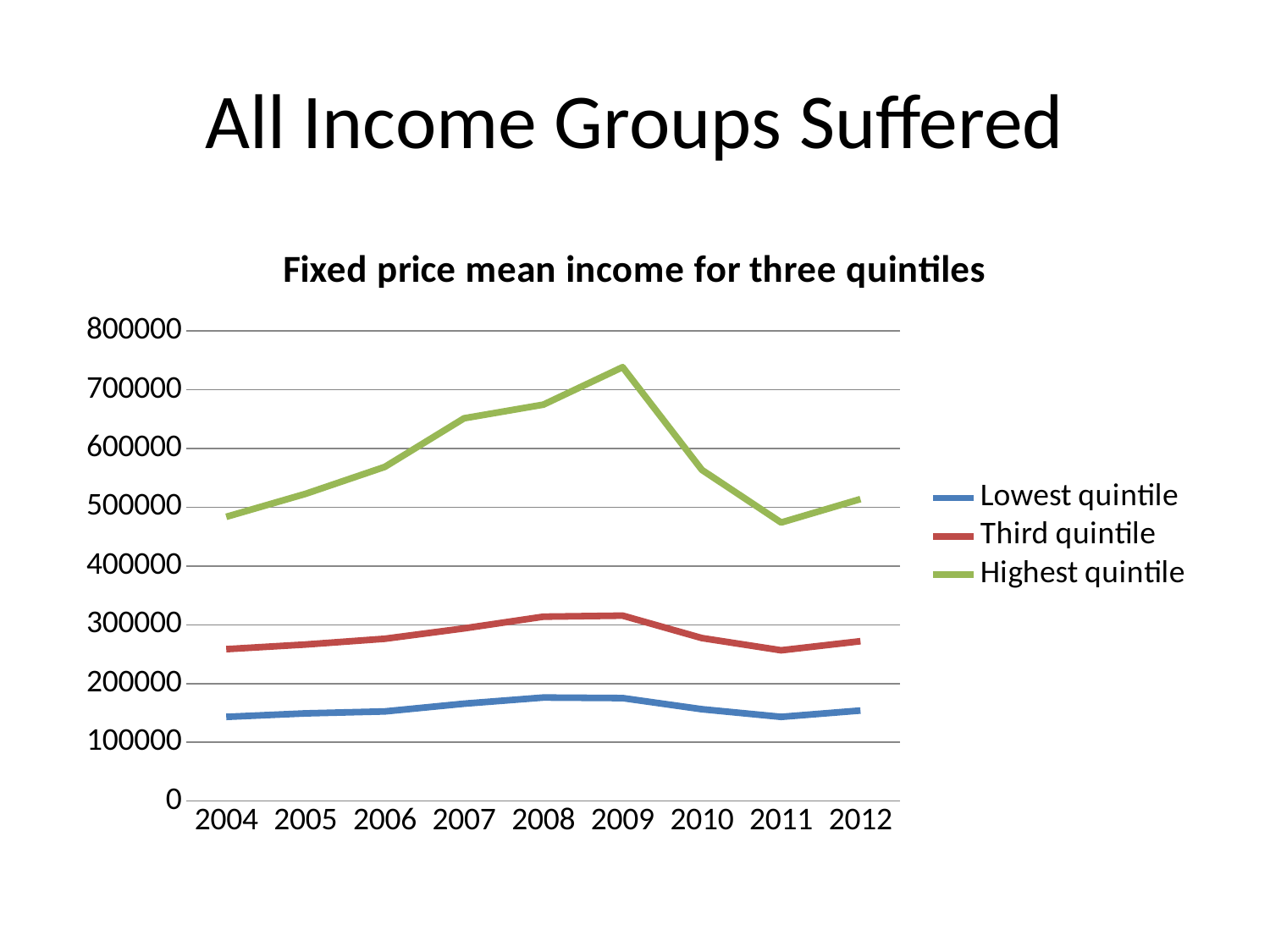
In which year does the Highest quintile series reach its highest value? 2009 Which series is drawn in green? Highest quintile Is the value for the Highest quintile in 2009 greater or less than 700000? greater How many series does the legend list? 3 Is the value for the Third quintile in 2009 greater or less than 300000? greater What kind of chart is shown on the slide? line chart For the Highest quintile, which year has the larger value, 2009 or 2012? 2009 What is the title of the chart? Fixed price mean income for three quintiles Does the Highest quintile series rise or fall between 2009 and 2011? fall Is the value for the Highest quintile in 2011 greater or less than 500000? less How many years are plotted along the x axis? 9